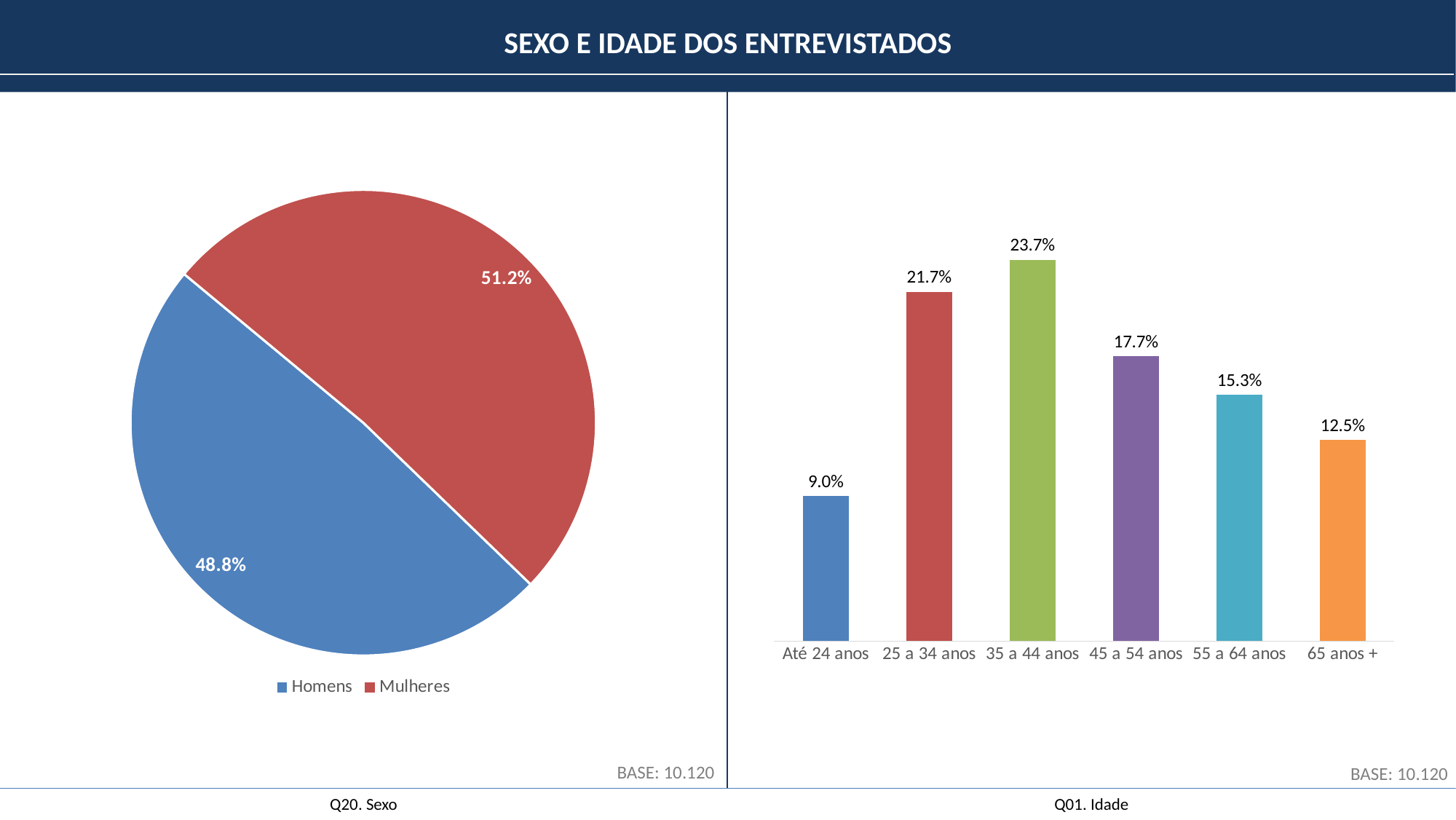
In the bar chart on the right, what is the difference between the values for 25 a 34 anos and 45 a 54 anos? 4.0% In the bar chart on the right, what is the value for 35 a 44 anos? 23.7% In the pie chart on the left, which slice is larger, Homens or Mulheres? Mulheres In the bar chart on the right, what is the value for 65 anos +? 12.5% In the bar chart on the right, how many age categories are shown? 6 In the pie chart on the left, what share of respondents are Homens? 48.8% In the bar chart on the right, which age group has the highest value? 35 a 44 anos In the bar chart on the right, do the values rise or fall from 35 a 44 anos to 65 anos +? Fall In the pie chart on the left, how many entries does the legend list? 2 What kind of chart is shown on the right side of the slide? Bar chart In the bar chart on the right, which age group has the lowest value? Até 24 anos In the pie chart on the left, what share of respondents are Mulheres? 51.2%